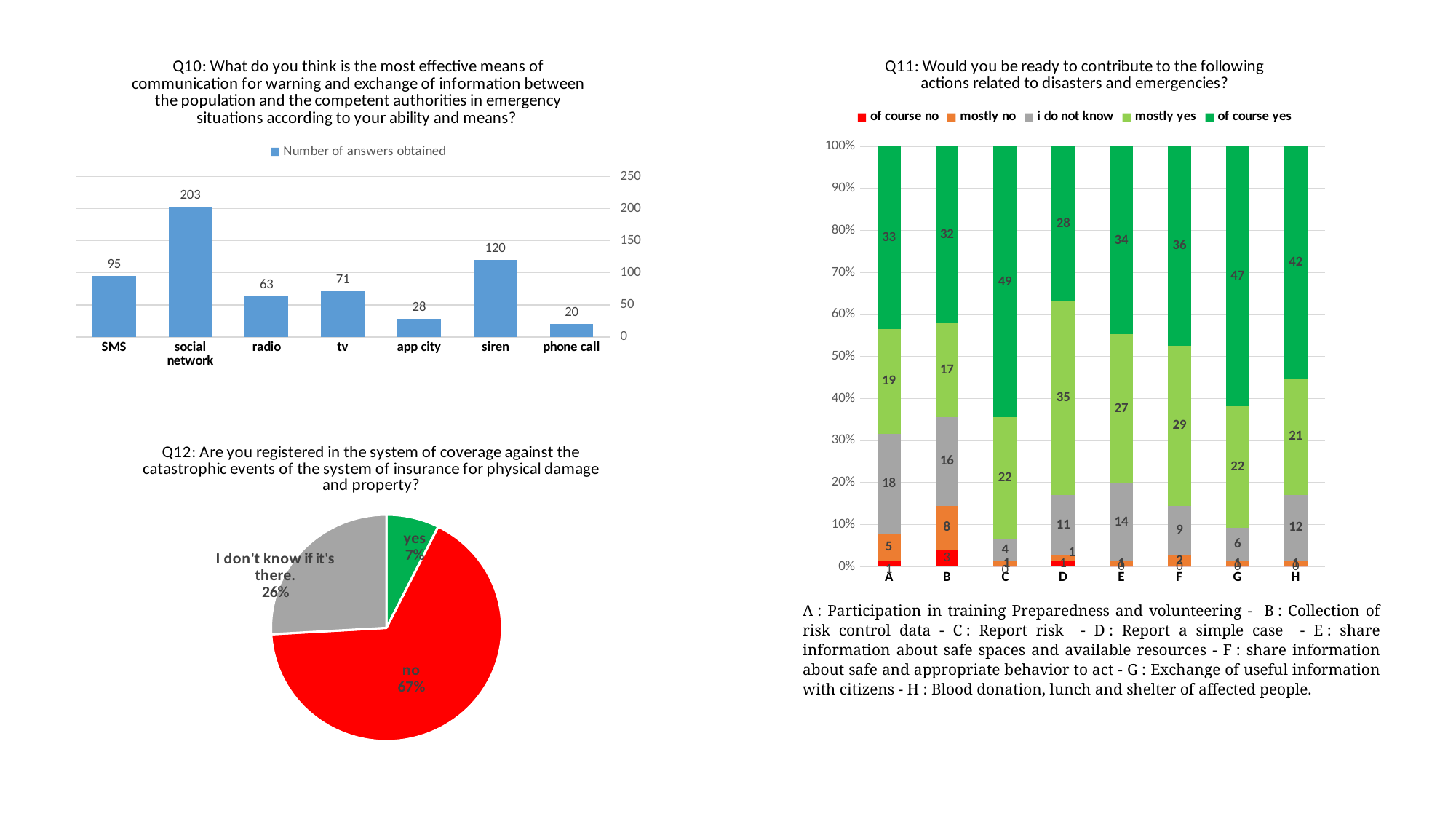
In the Q10 chart, which has more answers, radio or tv? tv How many categories are shown on the x axis of the Q10 chart? 7 In the Q12 pie chart, what share of respondents answered 'no'? 67% In the Q11 chart, what is the 'mostly yes' value for action D? 35 In the Q10 chart, how many answers were obtained for social network? 203 What type of chart is the Q12 chart? pie chart In the Q10 chart, which means of communication received the most answers? social network In the Q10 chart, what is the difference between the number of answers for siren and for SMS? 25 In the Q11 chart, what is the 'of course yes' value for action C? 49 In the Q12 pie chart, what percentage answered 'yes'? 7% How many series does the legend of the Q11 chart list? 5 In the Q10 chart, which means of communication received the fewest answers? phone call